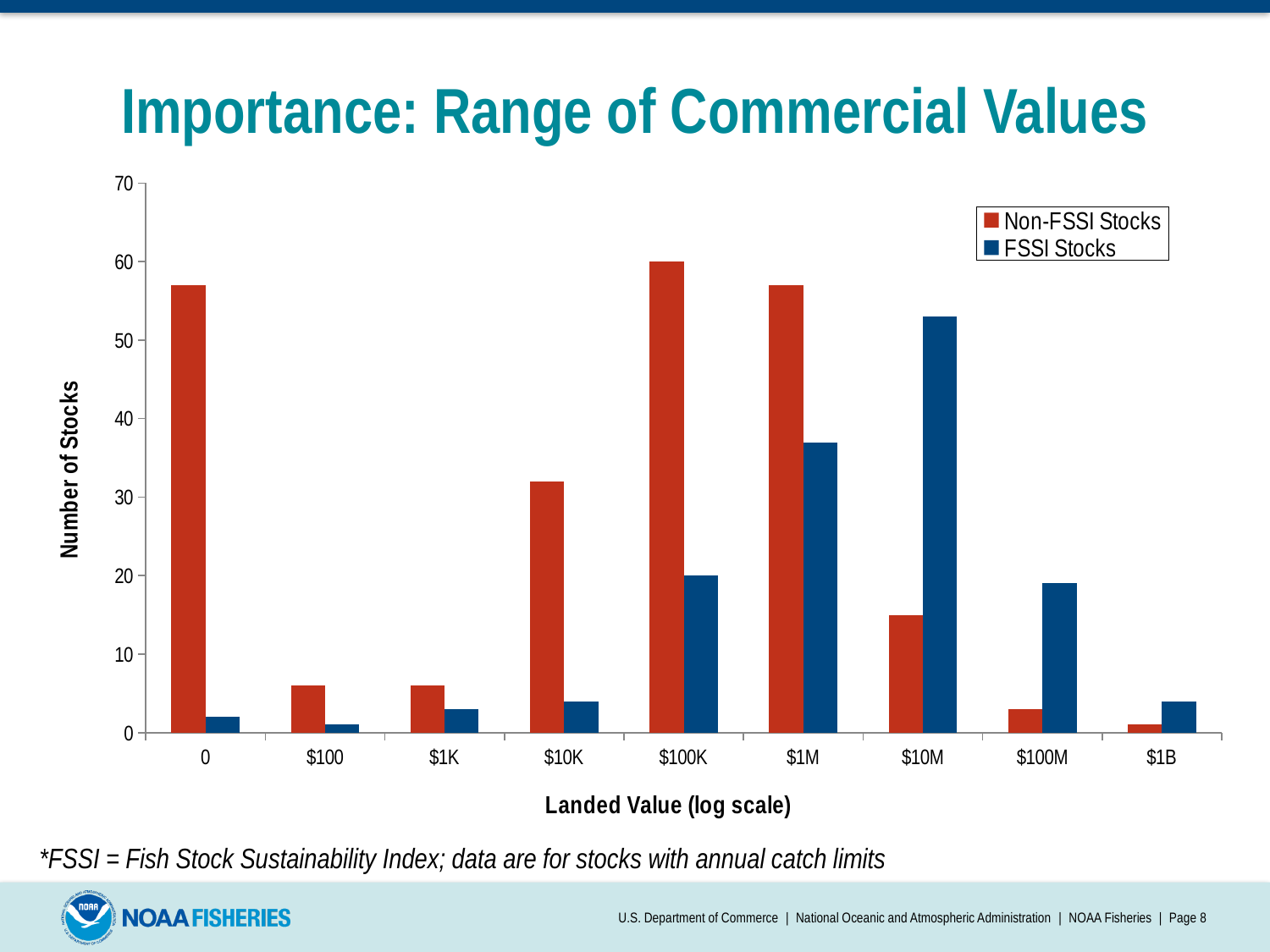
At $1M landed value, which series has more stocks, Non-FSSI Stocks or FSSI Stocks? Non-FSSI Stocks At $10M landed value, which series has more stocks, Non-FSSI Stocks or FSSI Stocks? FSSI Stocks Is the number of Non-FSSI Stocks at $10K landed value greater or less than 20? greater Which landed value category has the highest number of FSSI Stocks? $10M What is the title of the chart's y axis? Number of Stocks Which landed value category has the lowest number of FSSI Stocks? $100 Which landed value category has the lowest number of Non-FSSI Stocks? $1B What kind of chart is shown on the slide? bar chart Is the number of FSSI Stocks at $100M landed value greater or less than 30? less How many series does the legend list? 2 How many landed value categories are shown on the x axis? 9 Which landed value category has the highest number of Non-FSSI Stocks? $100K